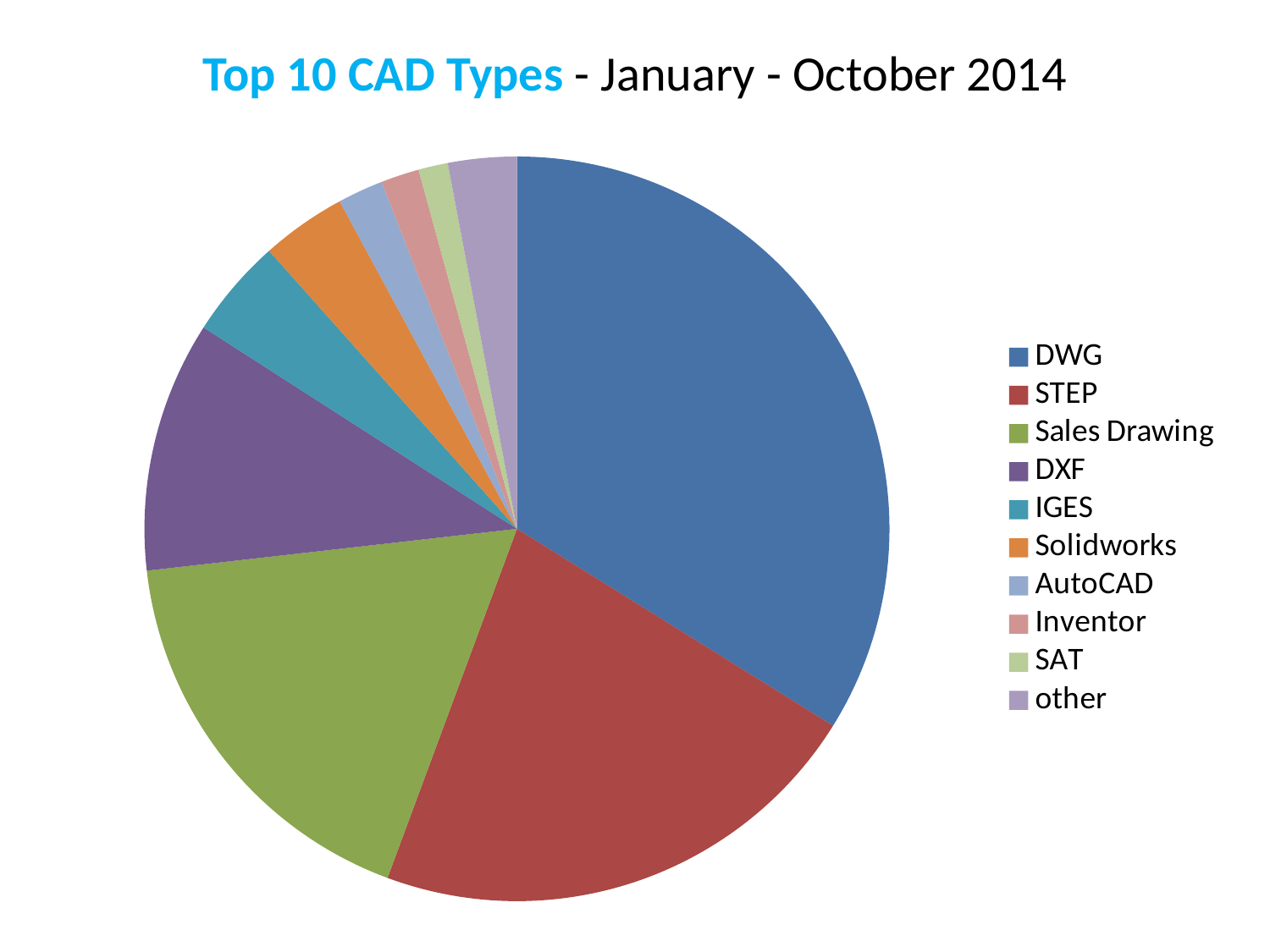
Which CAD type has the largest slice of the pie? DWG How many slices does the pie chart have? 10 What kind of chart is shown on the slide? pie chart Which slice is larger, Sales Drawing or DXF? Sales Drawing How many entries does the legend list? 10 What is the title of the chart? Top 10 CAD Types - January - October 2014 Which slice is larger, STEP or Sales Drawing? STEP Which slice is larger, DXF or Solidworks? DXF What colour is the DWG slice? blue